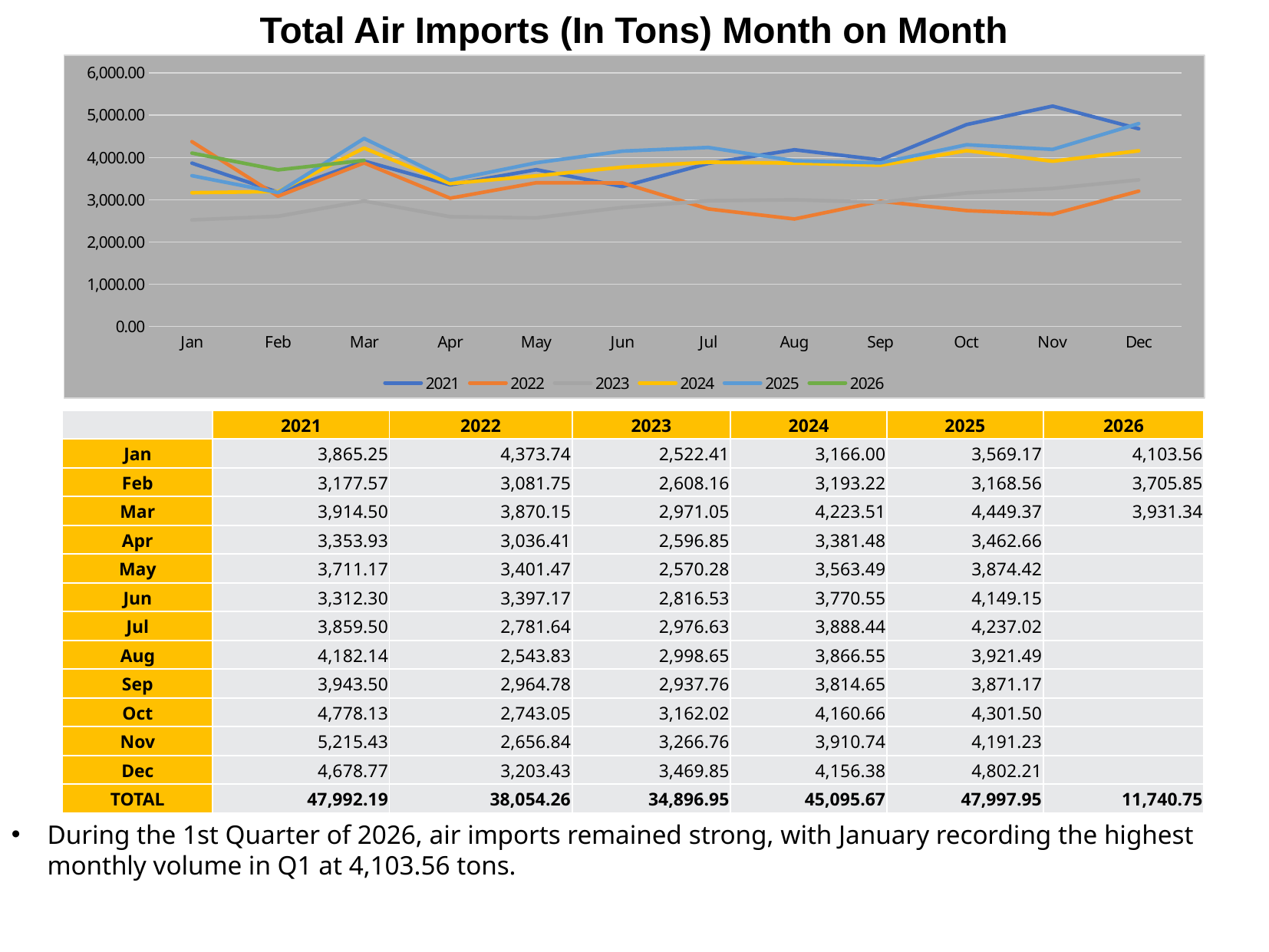
Is the value for 2021 in Nov greater or less than 5,000? greater Does the 2022 series rise or fall overall from Jan to Dec? fall How many months are plotted along the x axis? 12 In which month does the 2023 series have its lowest value? Jan What is the value for 2026 in Jan? 4,103.56 How many series does the chart legend list? 6 What is the TOTAL for 2024 shown in the table? 45,095.67 What kind of chart is shown on the slide? line chart What is the difference between the 2021 values for Nov and Oct? 437.30 What is the value for 2021 in Nov? 5,215.43 Which is larger in Jan, the value for 2021 or the value for 2022? 2022 In which month does the 2021 series reach its highest value? Nov